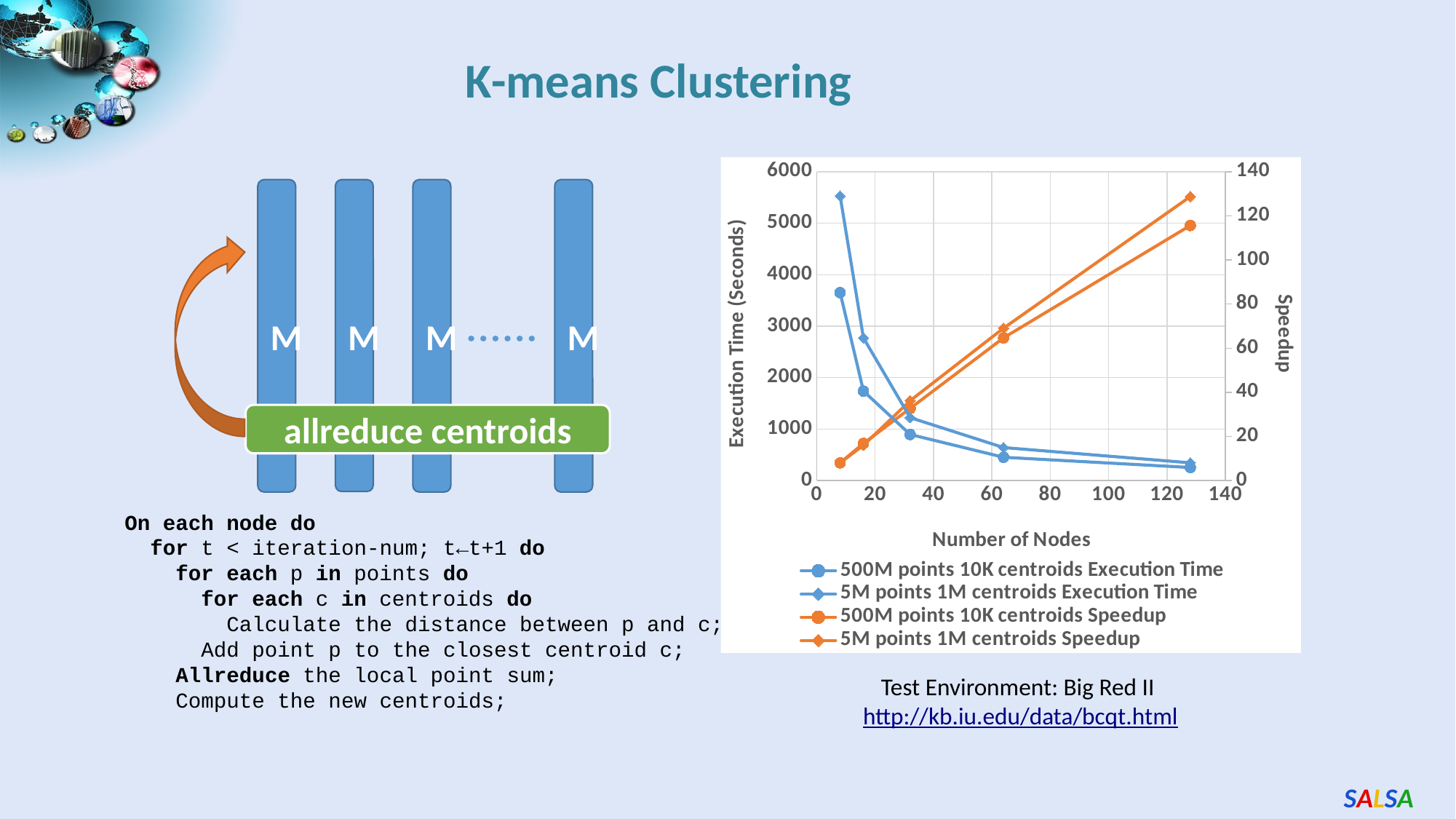
What kind of chart is shown on the slide? line chart At the smallest number of nodes, which series has the higher execution time: 500M points 10K centroids or 5M points 1M centroids? 5M points 1M centroids Execution Time What is the title of the x axis of the chart? Number of Nodes Do the speedup series rise or fall as the number of nodes increases? rise At the largest number of nodes, which speedup series is higher: 500M points 10K centroids or 5M points 1M centroids? 5M points 1M centroids Speedup Do the execution time series rise or fall as the number of nodes increases? fall Is the speedup for 500M points 10K centroids at the largest number of nodes greater or less than 100? greater Is the speedup for 5M points 1M centroids at the largest number of nodes greater or less than 120? greater What is the title of the left y axis of the chart? Execution Time (Seconds) Is the execution time for 500M points 10K centroids at the smallest number of nodes greater or less than 4000 seconds? less How many series does the chart legend list? 4